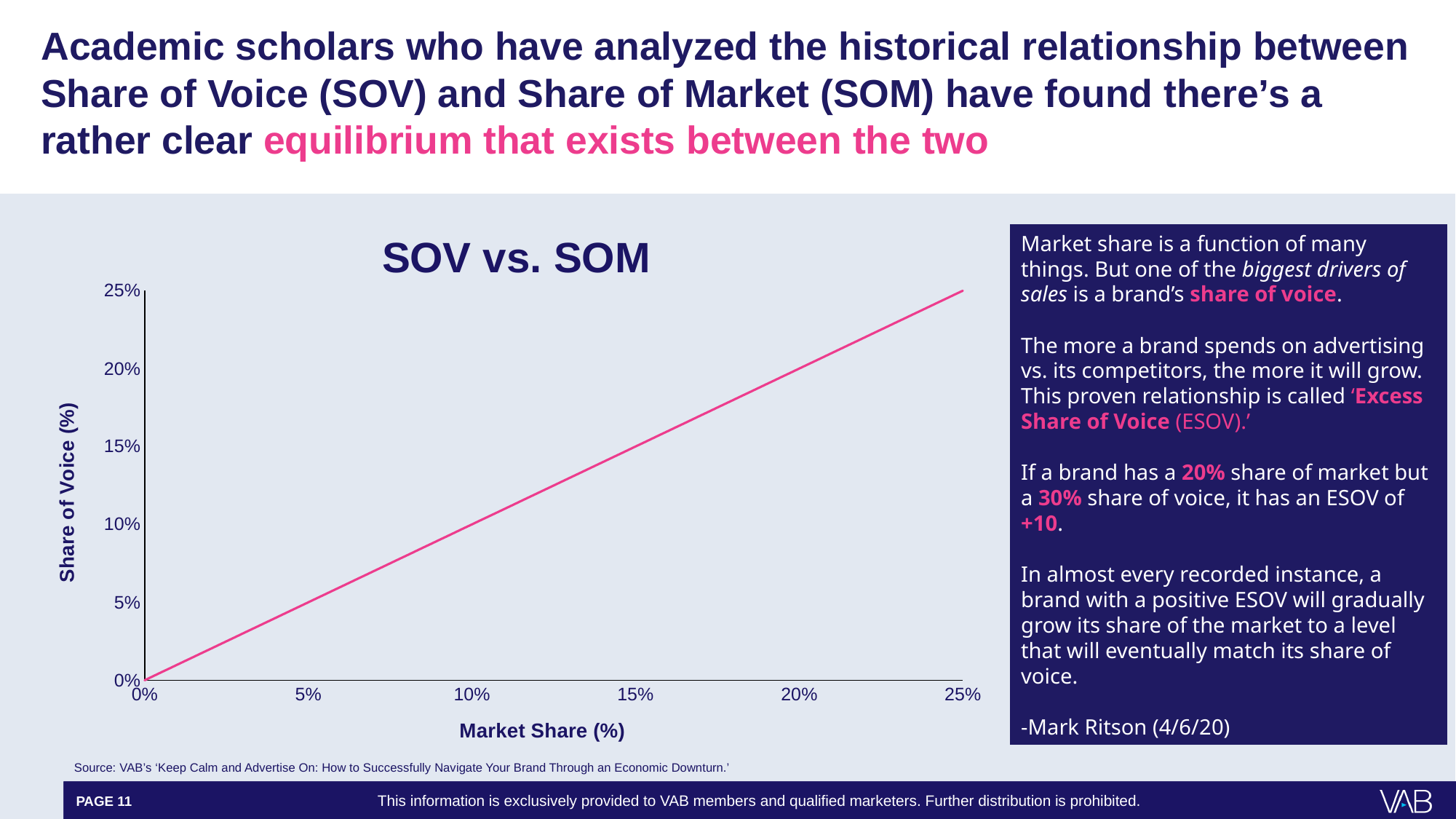
In the 'SOV vs. SOM' chart, is the Share of Voice at a Market Share of 10% greater or less than 5%? greater In the 'SOV vs. SOM' chart, is the Share of Voice at a Market Share of 20% greater or less than 15%? greater What is the title of the chart on the slide? SOV vs. SOM In the 'SOV vs. SOM' chart, which Market Share value has the higher Share of Voice, 5% or 20%? 20% What kind of chart is the 'SOV vs. SOM' chart? line chart In the 'SOV vs. SOM' chart, is the Share of Voice at a Market Share of 5% greater or less than 10%? less What is the label of the x axis of the 'SOV vs. SOM' chart? Market Share (%) What is the highest value shown on the y axis of the 'SOV vs. SOM' chart? 25% In the 'SOV vs. SOM' chart, does Share of Voice rise or fall as Market Share increases? rise How many tick labels are shown on the x axis of the 'SOV vs. SOM' chart? 6 In the 'SOV vs. SOM' chart, what is the Share of Voice value where the line ends at a Market Share of 25%? 25% In the 'SOV vs. SOM' chart, what is the Share of Voice value where the line starts at a Market Share of 0%? 0%